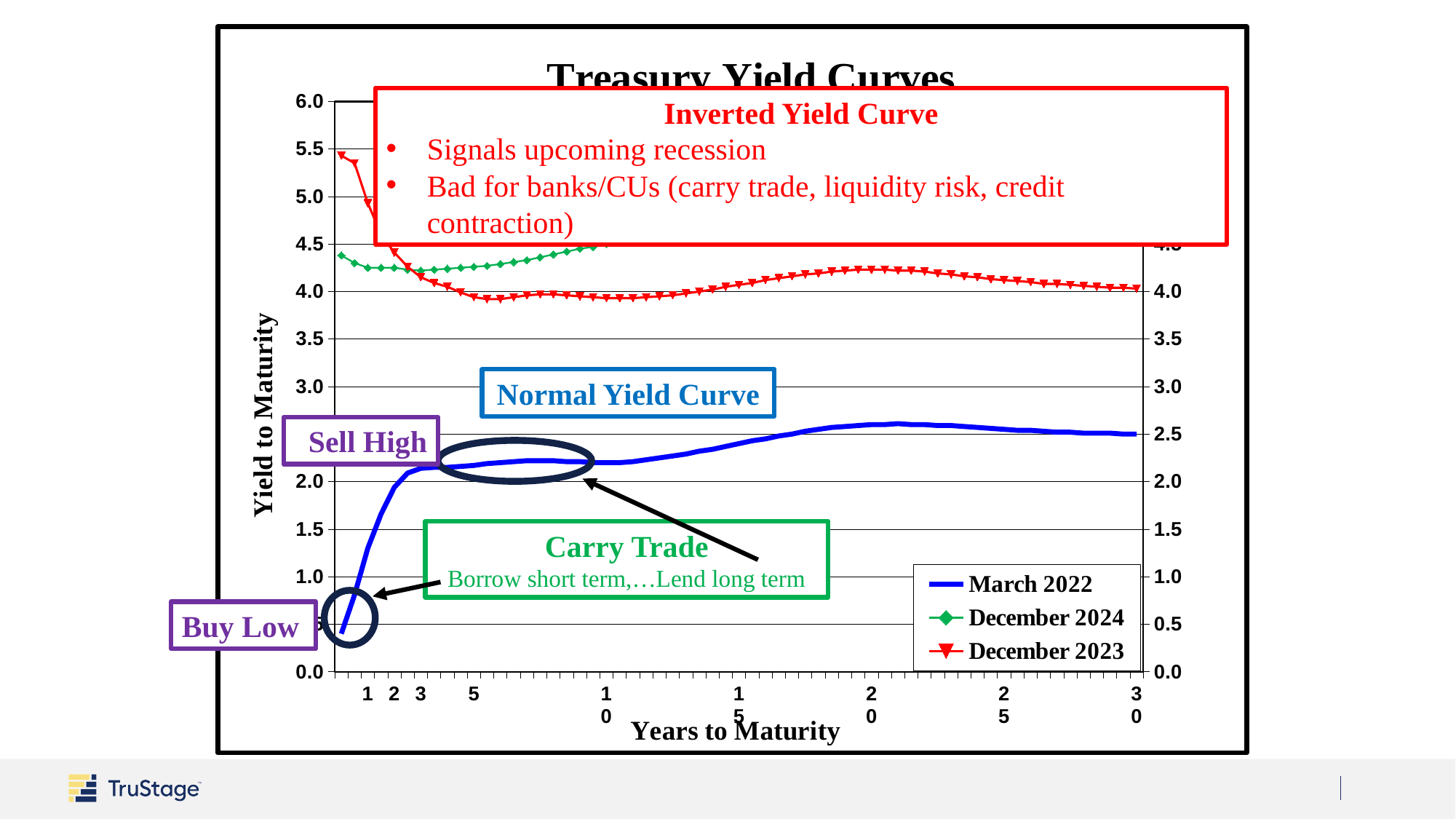
At 30 years to maturity, which is higher: March 2022 or December 2023? December 2023 Does the March 2022 curve rise or fall between 1 and 5 years to maturity? rise At 5 years to maturity, which is higher: March 2022 or December 2024? December 2024 Does the December 2023 curve rise or fall between 1 and 5 years to maturity? fall Is the March 2022 value at 5 years to maturity greater or less than 3.0? less What is the label of the x axis? Years to Maturity Is the December 2023 value at 30 years to maturity greater or less than 3.5? greater Is the March 2022 value at 30 years to maturity greater or less than 3.0? less What kind of chart is shown on the slide? line chart What is the title of the chart? Treasury Yield Curves How many series does the legend list? 3